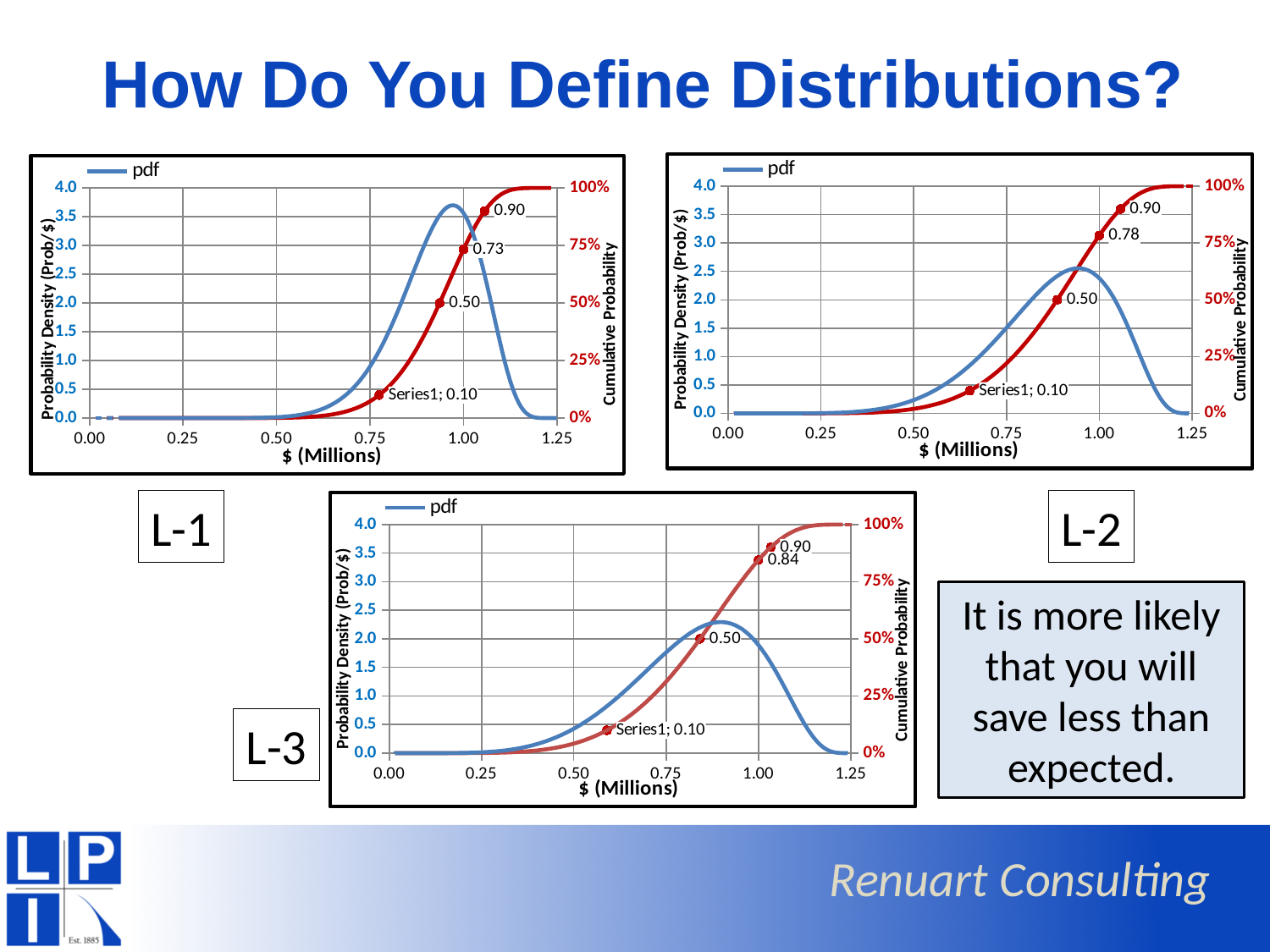
On the L-1 chart, is the peak of the pdf curve greater or less than 3.5 on the left axis? greater On the L-3 chart, what is the lowest labeled value on the cumulative probability curve? 0.10 On the L-3 chart, is the peak of the pdf curve greater or less than 3.0 on the left axis? less What kind of chart is the L-1 chart? line chart On the L-1 chart, what is the labeled value on the cumulative probability curve between the 0.50 and 0.90 points? 0.73 On the L-3 chart, what is the labeled value on the cumulative probability curve between the 0.50 and 0.90 points? 0.84 Which chart has the larger labeled value between its 0.50 and 0.90 points, L-1 or L-2? L-2 On the L-2 chart, what is the labeled value on the cumulative probability curve between the 0.50 and 0.90 points? 0.78 What is the x-axis title on the L-1 chart? $ (Millions) Which of the three charts has the highest pdf peak? L-1 On the L-2 chart, how many labeled points are marked on the cumulative probability curve? 4 What is the difference between the L-3 chart's 0.84 labeled point and the L-1 chart's 0.73 labeled point? 0.11